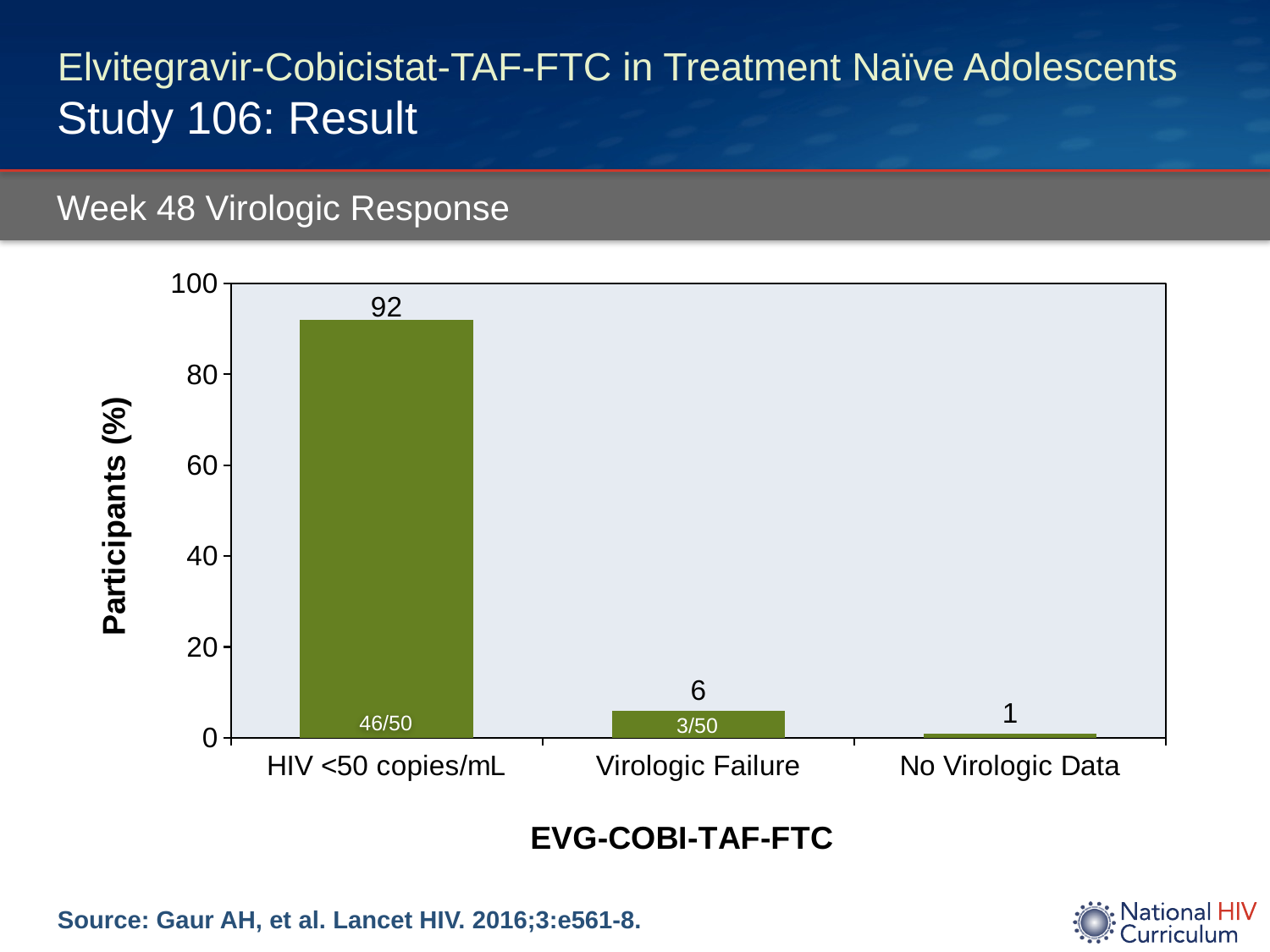
What is the difference in percentage points between HIV <50 copies/mL and Virologic Failure? 86 What fraction of participants is shown inside the HIV <50 copies/mL bar? 46/50 What percentage of participants had HIV <50 copies/mL at week 48? 92 What type of chart is shown on the slide? Bar chart Which category has the highest percentage of participants? HIV <50 copies/mL Which is larger, the value for Virologic Failure or the value for No Virologic Data? Virologic Failure What percentage of participants had No Virologic Data? 1 What percentage of participants had Virologic Failure? 6 How many categories are shown on the x axis? 3 What fraction of participants is shown inside the Virologic Failure bar? 3/50 Which category has the lowest percentage of participants? No Virologic Data Is the value for HIV <50 copies/mL greater or less than 80? greater